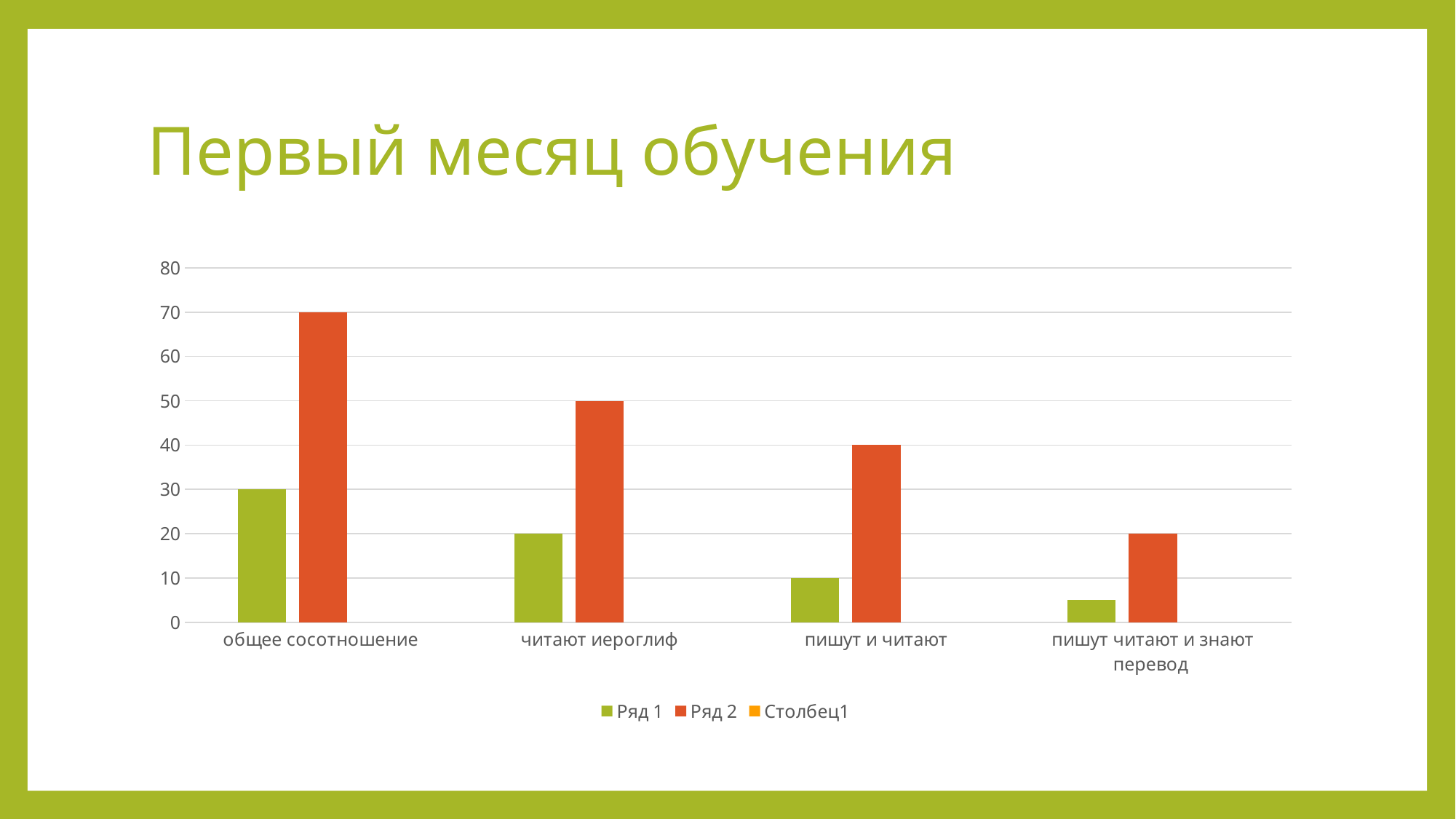
Is the value of Ряд 1 for пишут читают и знают перевод greater or less than 10? less How many categories are shown on the x axis? 4 What is the title of the slide? Первый месяц обучения What is the value of Ряд 1 for читают иероглиф? 20 What is the value of Ряд 2 for пишут и читают? 40 What kind of chart is shown on the slide? bar chart Which category has the highest value for Ряд 2? общее сосотношение What is the difference between Ряд 2 and Ряд 1 for общее соотношение? 40 Do the values of Ряд 2 rise or fall from left to right along the x axis? fall Which category has the lowest value for Ряд 1? пишут читают и знают перевод What is the value of Ряд 2 for общее соотношение? 70 How many series does the legend list? 3